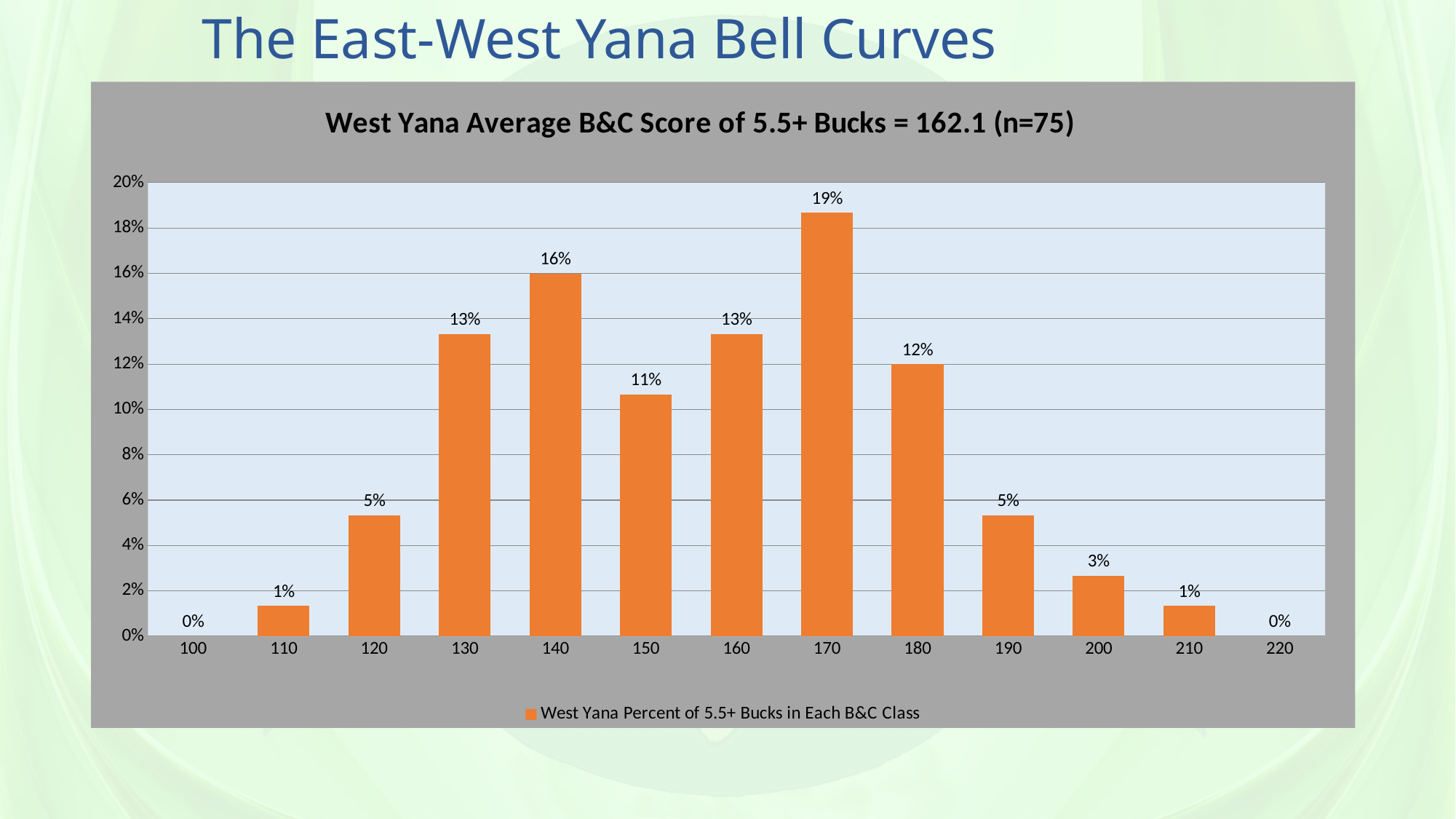
Is the value for the 130 class greater or less than 10%? greater Do the values rise or fall from the 170 class to the 220 class? Fall How many series does the legend list? 1 What is the title of the chart? West Yana Average B&C Score of 5.5+ Bucks = 162.1 (n=75) Which is larger, the value for the 140 class or the value for the 150 class? 140 What is the value for the 170 B&C class? 19% What kind of chart is shown on the slide? Bar chart What is the value for the 200 B&C class? 3% What is the value for the 140 B&C class? 16% Which B&C class has the highest percentage of 5.5+ bucks? 170 How many B&C classes are shown on the x axis? 13 What is the difference between the values for the 170 and 180 B&C classes? 7%